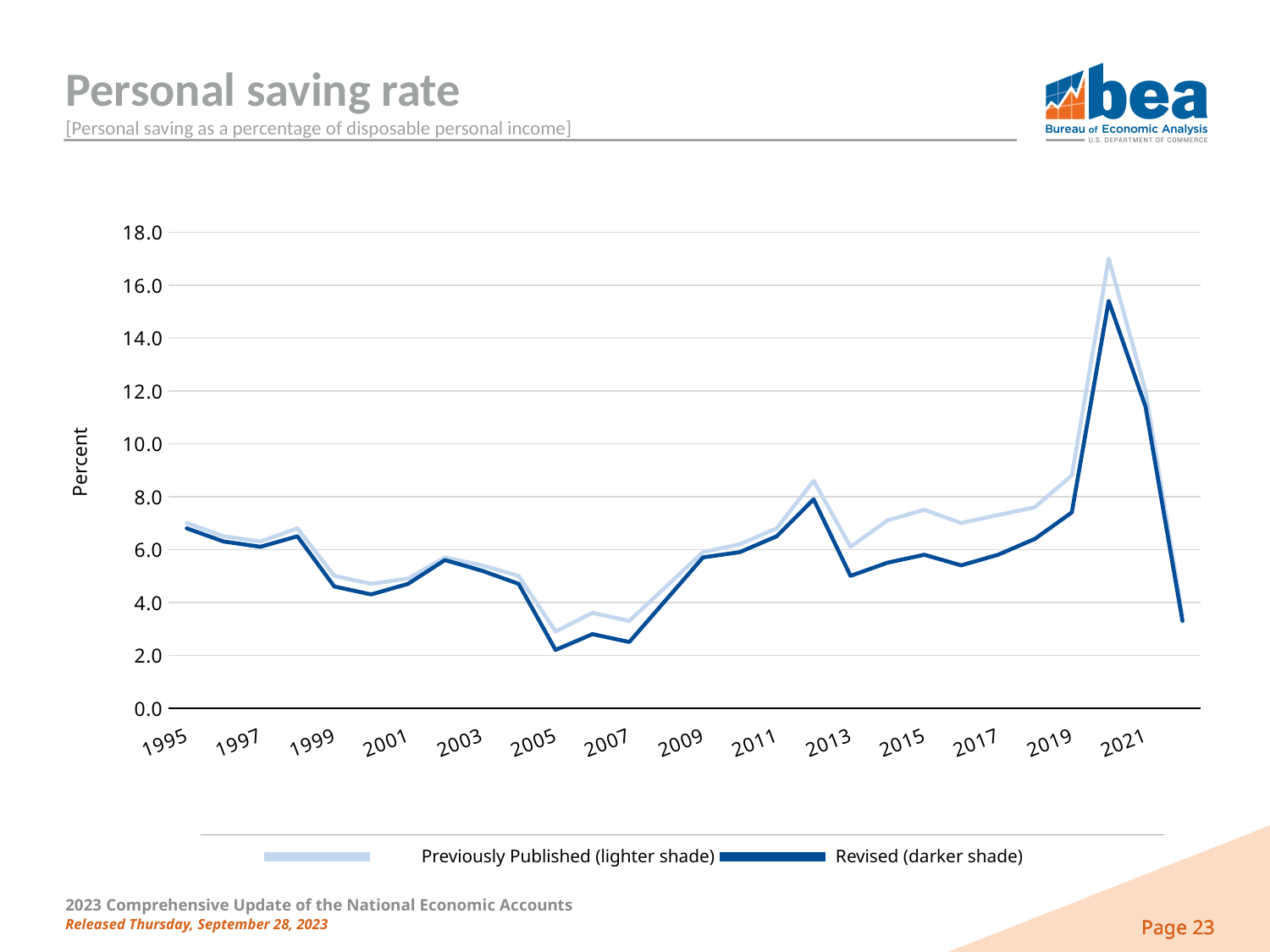
What kind of chart is shown on the slide? line chart Do the values of the Revised series rise or fall from 2020 to 2022? fall In which year does the Revised series reach its highest value? 2020 In which year does the Revised series reach its lowest value? 2005 What is the title of the chart on the slide? Personal saving rate Is the Revised value for 2020 greater or less than 14.0? greater What is the label on the vertical axis? Percent In 2020, which series has the higher value, Previously Published or Revised? Previously Published How many series does the legend list? 2 Is the Revised value for 1995 greater or less than 6.0? greater Is the Revised value for 2005 greater or less than 4.0? less